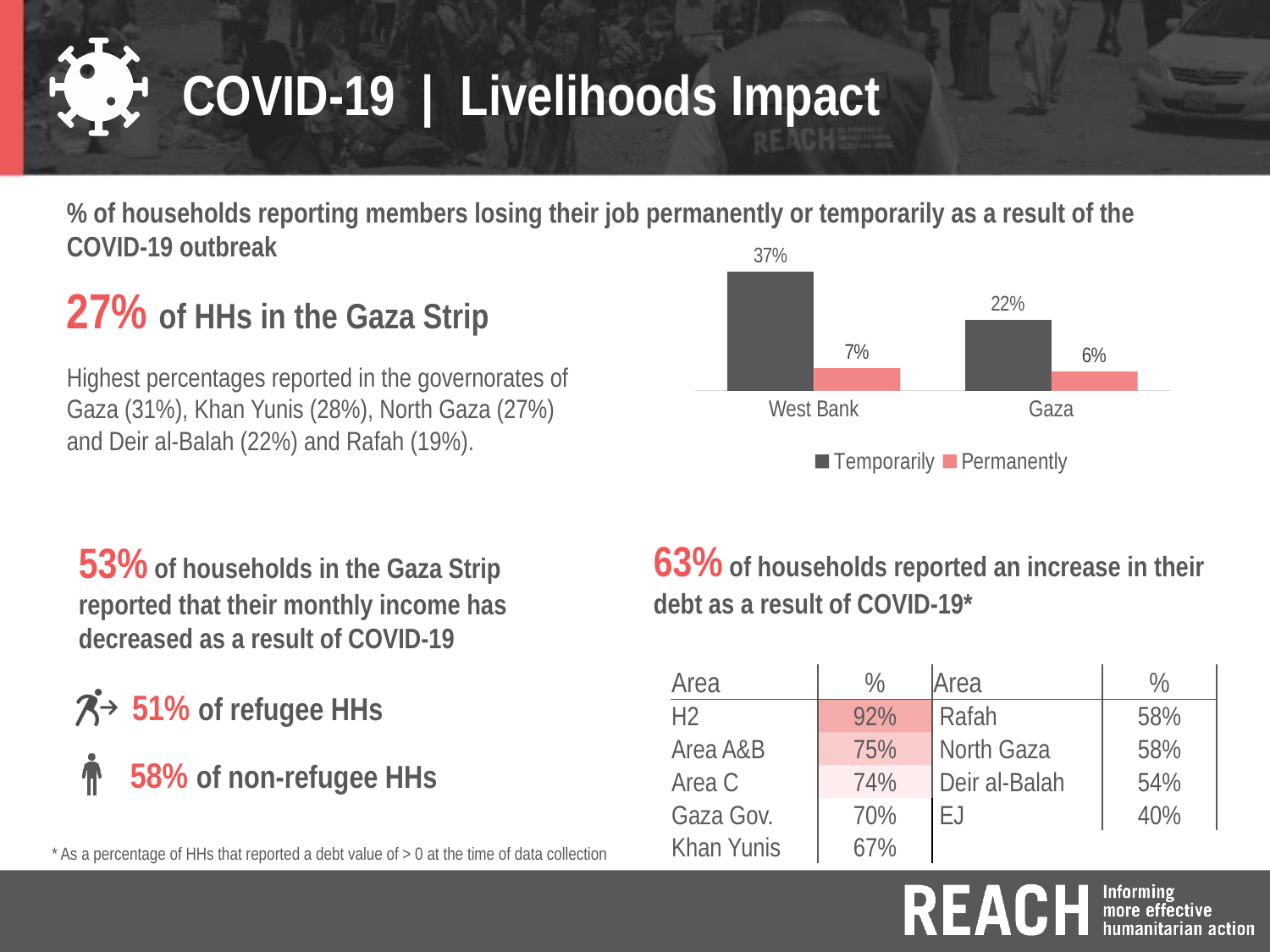
What percentage of households in the West Bank reported members losing their job temporarily? 37% How many series does the chart legend list? 2 What is the value for Temporarily in Gaza? 22% How many regions are shown on the x axis of the chart? 2 What type of chart is shown on the slide? bar chart What is the value for Permanently in the West Bank? 7% Which colour represents the Permanently series in the chart? red Which region has the highest value for Temporarily job loss? West Bank Is the Temporarily value for the West Bank larger or smaller than the Temporarily value for Gaza? larger Which bar in the chart has the lowest value? Permanently in Gaza What is the difference between the Temporarily values for the West Bank and Gaza? 15% What percentage of households in Gaza reported members losing their job permanently? 6%